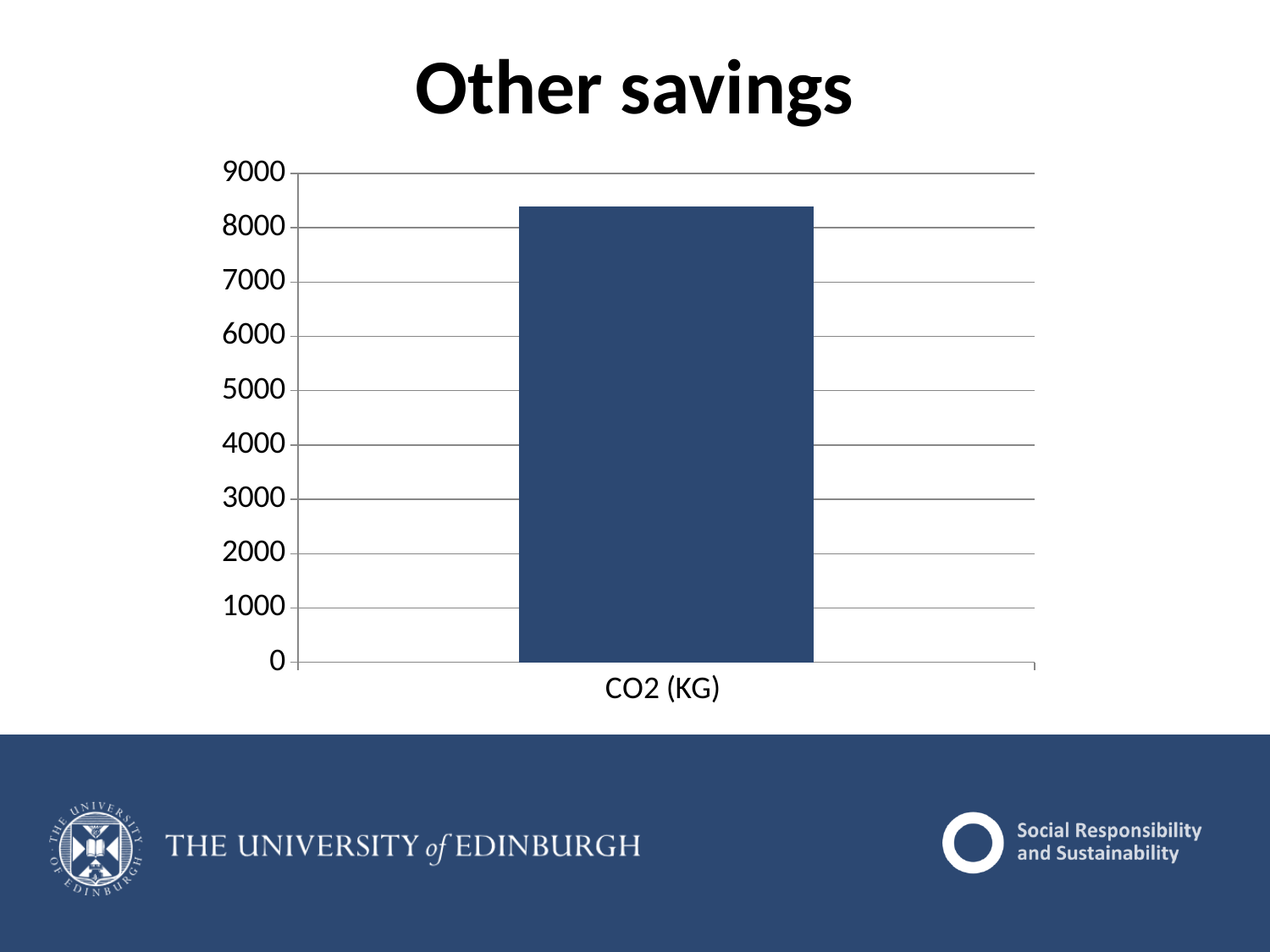
What is the category label on the x axis of the chart? CO2 (KG) What kind of chart is shown on the slide? bar chart Is the value for CO2 (KG) greater or less than 5000? greater Is the value for CO2 (KG) greater or less than 8000? greater How many bars does the chart show? 1 Is the value for CO2 (KG) greater or less than 9000? less What is the title of the chart on the slide? Other savings What is the highest value shown on the y axis of the chart? 9000